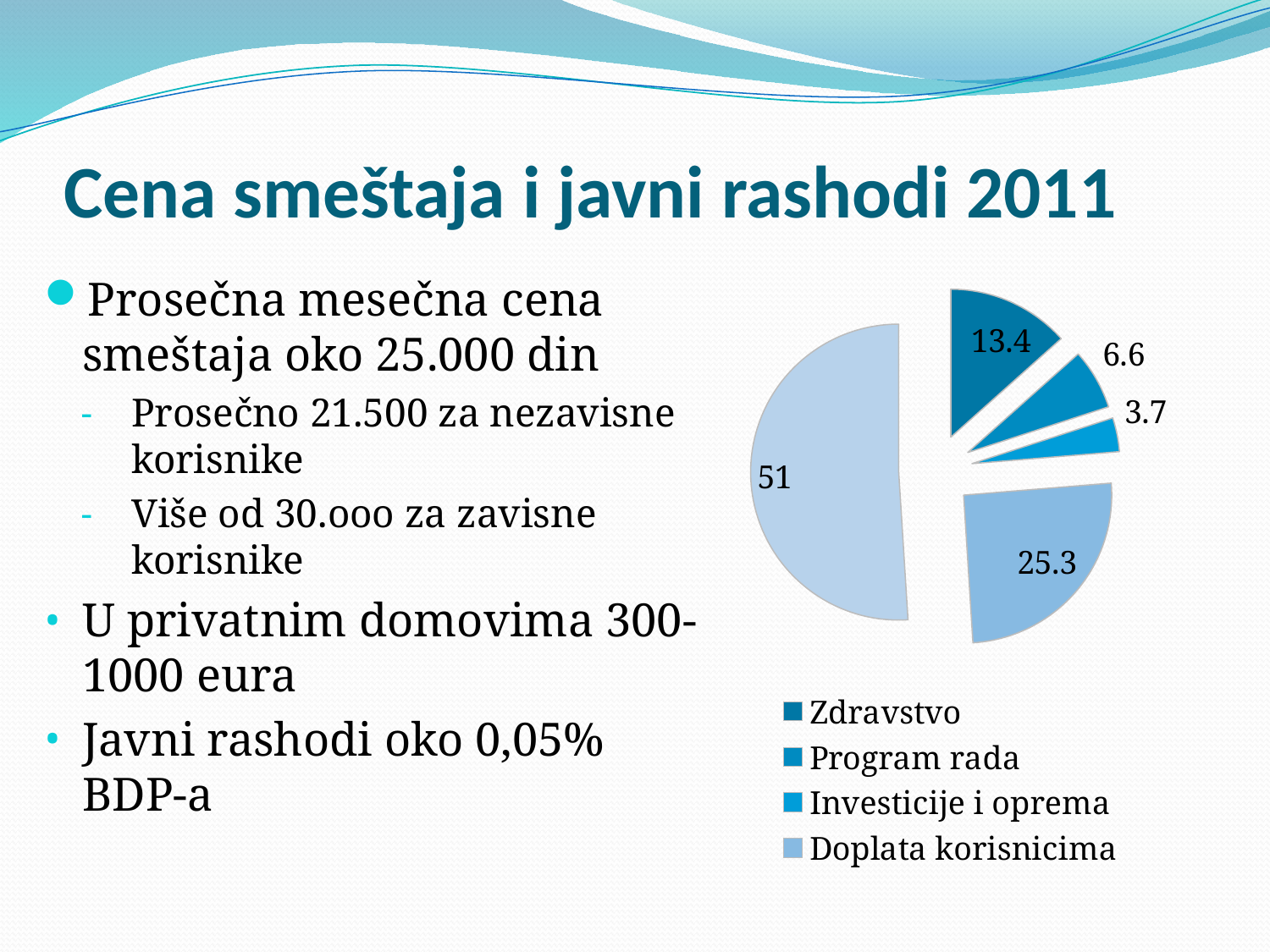
What kind of chart is shown on the slide? pie chart What is the value of the Zdravstvo slice in the pie chart? 13.4 Which slice is larger, Program rada or Investicije i oprema? Program rada What is the total of all the values labelled on the pie chart? 100 What is the value of the Investicije i oprema slice in the pie chart? 3.7 How many entries does the legend of the pie chart list? 4 What is the difference between the Doplata korisnicima slice and the Zdravstvo slice? 11.9 How many slices does the pie chart have? 5 Which legend category has the smallest slice in the pie chart? Investicije i oprema What is the value of the Program rada slice in the pie chart? 6.6 What is the largest value labelled on the pie chart? 51 What is the value of the Doplata korisnicima slice in the pie chart? 25.3